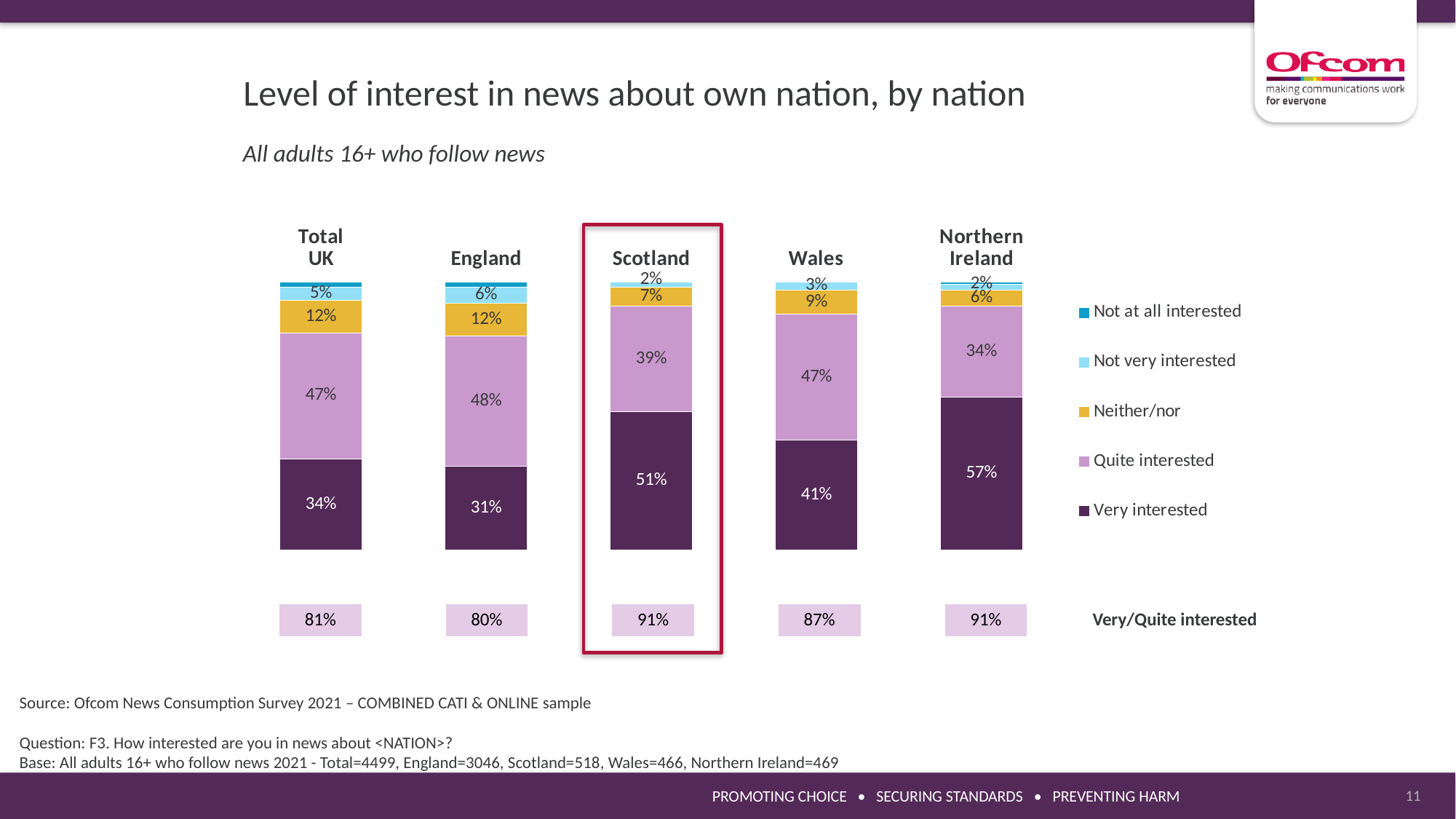
What is the Quite interested value for England? 48% Which nation has the highest Very interested percentage? Northern Ireland What is the difference between the Very interested percentages for Northern Ireland and Total UK? 23% What percentage of adults in Scotland are very interested in news about their own nation? 51% Which is larger, the Quite interested value for Scotland or for Wales? Wales How many nation categories are shown in the chart? 5 Which nation is highlighted with a red outline on the chart? Scotland Which nation has the lowest Very interested percentage? England What kind of chart is shown on the slide? Stacked bar chart How many series does the legend list? 5 What is the Neither/nor value for Wales? 9% What is the combined Very/Quite interested figure shown for Wales? 87%